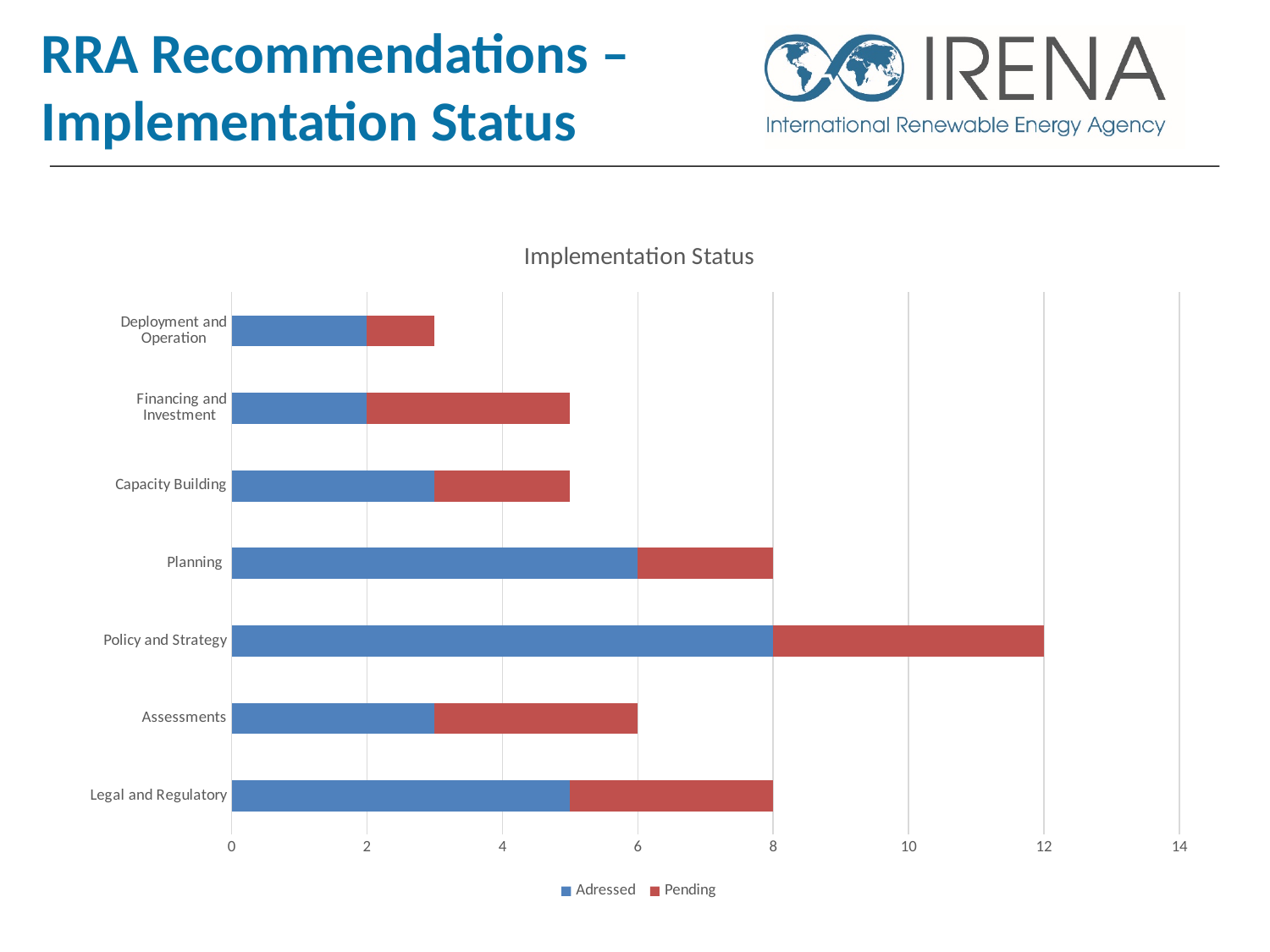
What kind of chart is shown on the slide? Stacked bar chart Which category has the shortest total bar in the Implementation Status chart? Deployment and Operation Which category has the longest total bar in the Implementation Status chart? Policy and Strategy Is the total bar for Capacity Building greater or less than 4? greater How many categories are shown on the Implementation Status chart? 7 How many series does the legend of the Implementation Status chart list? 2 What is the Adressed value for Policy and Strategy? 8 What is the total of the stacked bar for Legal and Regulatory? 8 What is the Pending value for Planning, given its Adressed value of 6 and total of 8? 2 What is the Adressed value for Planning? 6 Which has the larger total bar, Planning or Assessments? Planning What is the total of the stacked bar for Policy and Strategy? 12